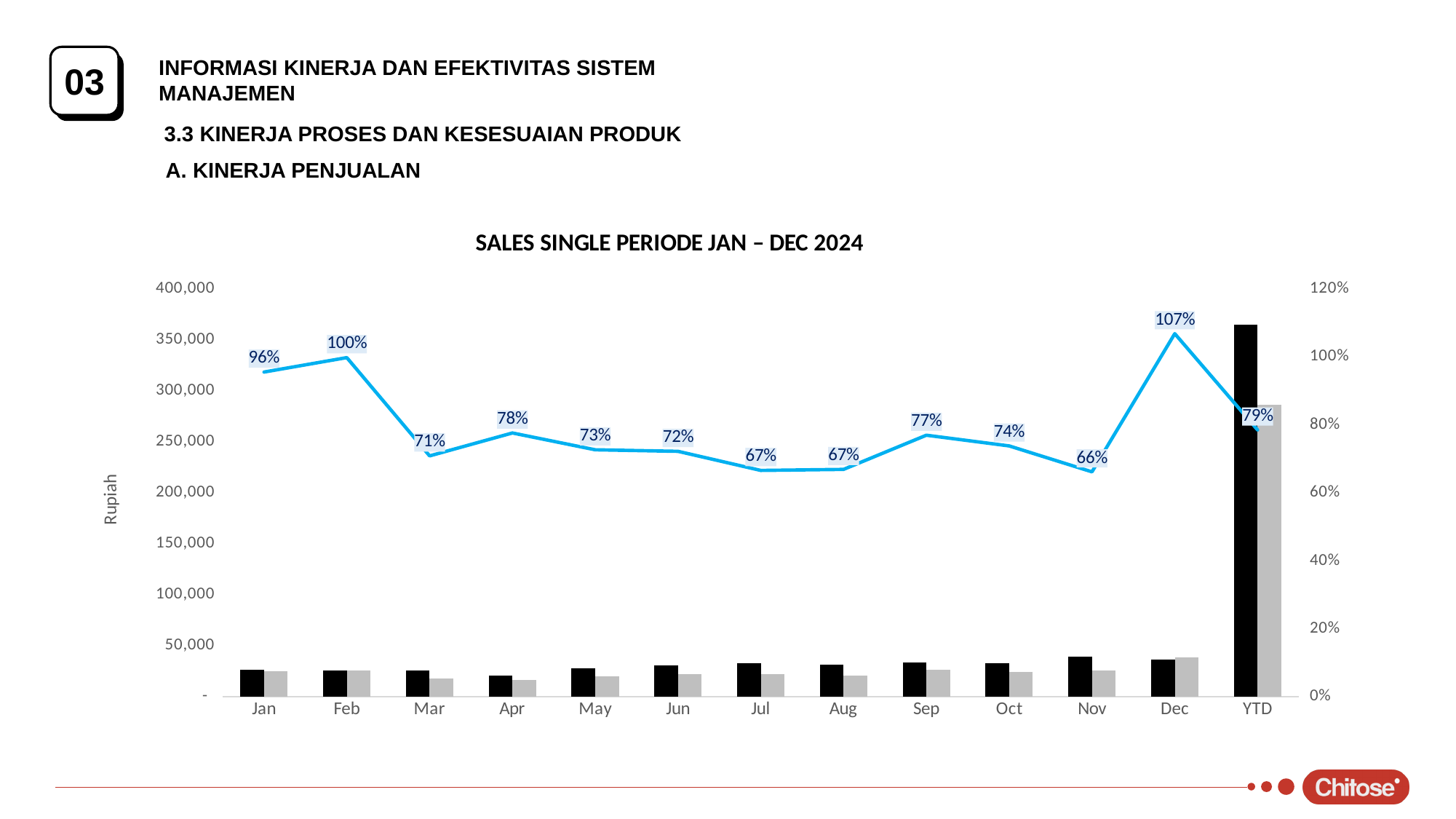
What percentage is shown on the line for YTD? 79% How many categories are shown on the x axis? 13 Which category has the highest percentage on the line? Dec What kind of chart is this? Combined bar and line chart Which category has the lowest percentage on the line? Nov What percentage is shown on the line for Nov? 66% What percentage is shown on the line for Dec? 107% What is the difference between the Dec percentage and the Nov percentage on the line? 41% Which has a higher percentage on the line, Sep or Oct? Sep What is the title of the chart? SALES SINGLE PERIODE JAN – DEC 2024 Is the value of the black bar for YTD greater or less than 300,000? greater What percentage is shown on the line for Feb? 100%